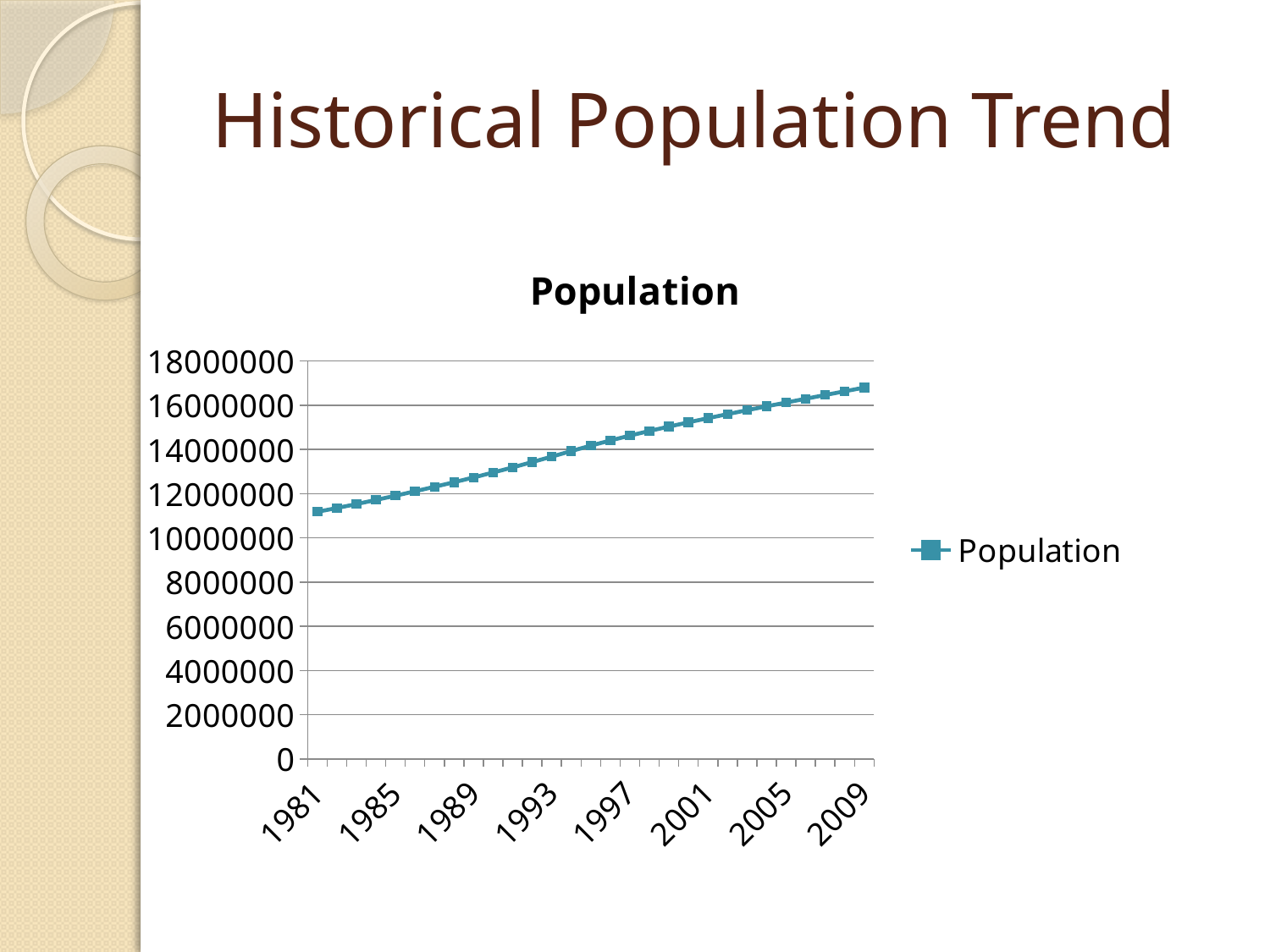
Is the population value for 2009 greater or less than 16000000? greater What is the name of the series shown in the legend? Population What is the title of the chart? Population Is the population value for 1981 greater or less than 12000000? less How many year labels are shown on the x axis? 8 Which year has the lowest population value? 1981 Do the population values rise or fall from 1981 to 2009? rise Is the population value for 1981 greater or less than 10000000? greater How many series does the legend list? 1 Which year has the larger population value, 1989 or 2005? 2005 What kind of chart is shown on the slide? line chart Which year has the highest population value? 2009